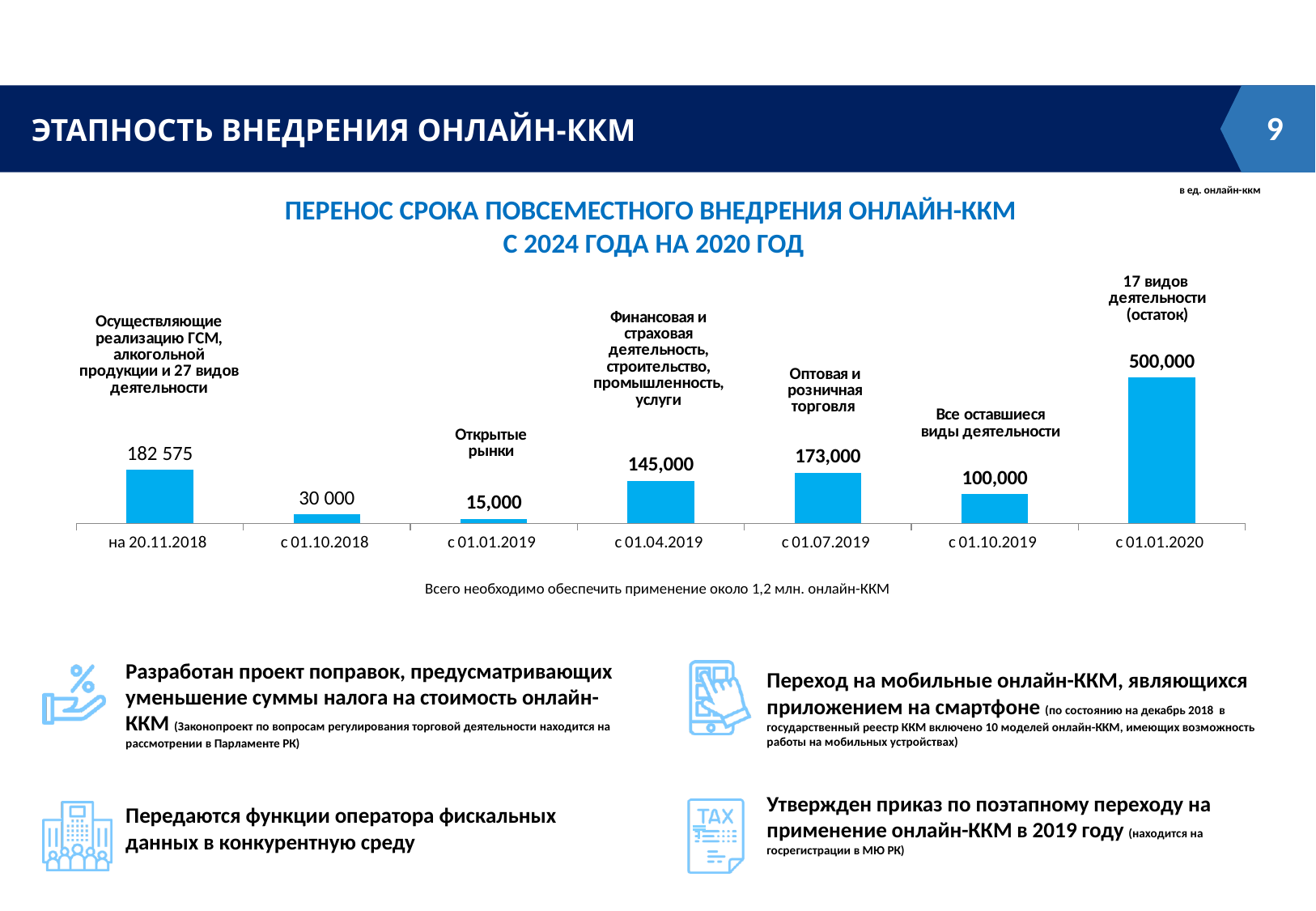
How many bars (categories) are shown on the chart? 7 What unit is stated for the chart values in the top-right note? в ед. онлайн-ККМ Which category has the highest value on the chart? с 01.01.2020 Which category has the lowest value on the chart? с 01.01.2019 What is the difference between the values for "с 01.07.2019" and "с 01.04.2019"? 28,000 What value is shown for the bar labelled "с 01.04.2019" (Финансовая и страховая деятельность, строительство, промышленность, услуги)? 145,000 What value is shown for the bar labelled "с 01.01.2020"? 500,000 What value is shown for the bar labelled "с 01.01.2019" (Открытые рынки)? 15,000 Which is larger: the value for "с 01.10.2019" or the value for "с 01.04.2019"? с 01.04.2019 What type of chart is shown on the slide? bar chart What value is shown for the bar labelled "на 20.11.2018"? 182 575 What is the difference between the values for "с 01.01.2020" and "с 01.07.2019"? 327,000